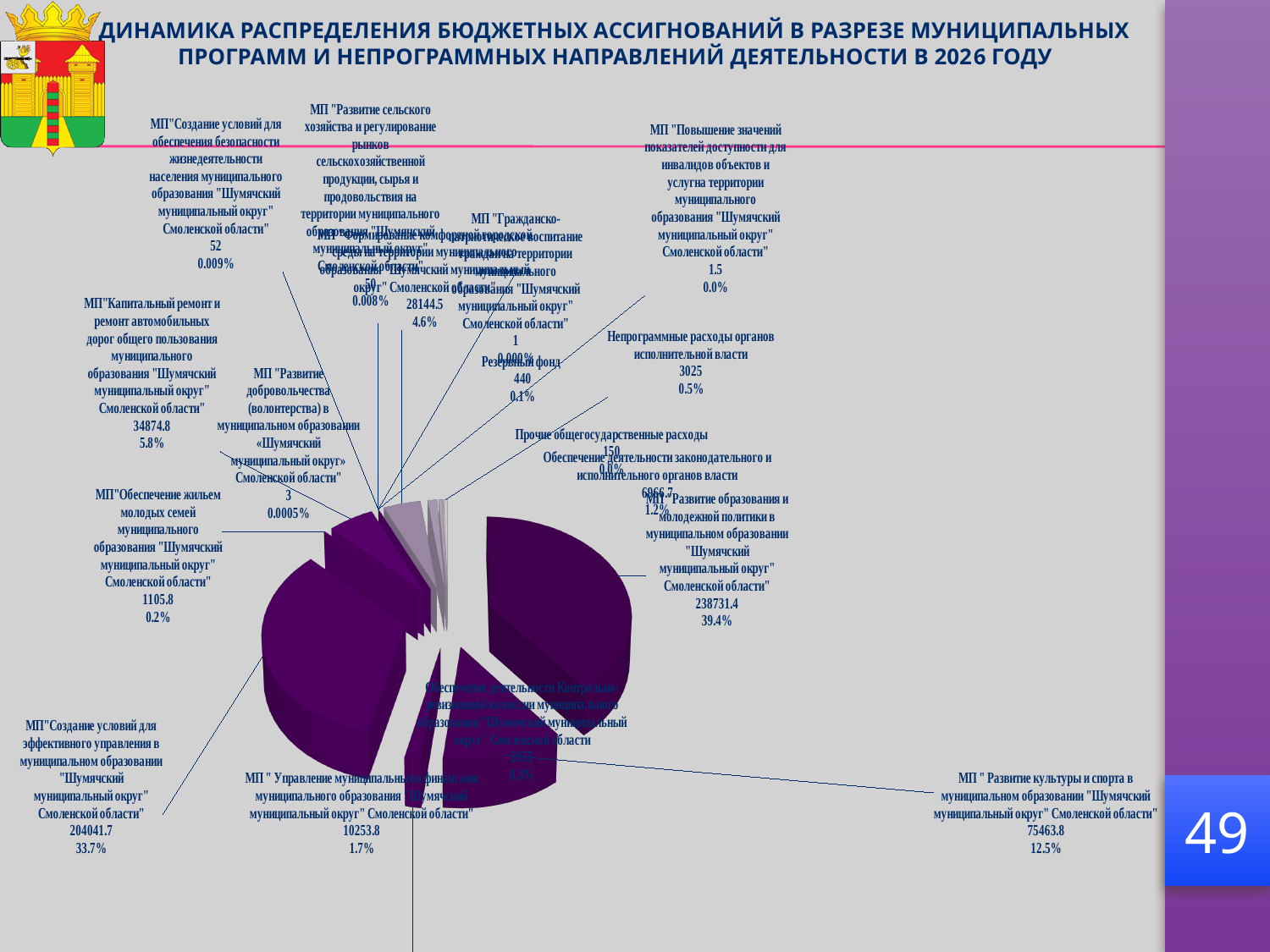
What value is shown for МП "Капитальный ремонт и ремонт автомобильных дорог общего пользования"? 34874.8 What kind of chart is shown on the slide? pie chart What share of the pie does МП "Управление муниципальными финансами" account for? 1.7% What value is shown for Резервный фонд? 440 What is the difference between the value for МП "Развитие образования и молодежной политики" and the value for МП "Создание условий для эффективного управления"? 34689.7 What share of the pie does МП "Развитие образования и молодежной политики" account for? 39.4% What value is shown for МП "Развитие образования и молодежной политики в муниципальном образовании "Шумячский муниципальный округ" Смоленской области"? 238731.4 Which is larger: the value for МП "Развитие культуры и спорта" or the value for МП "Капитальный ремонт и ремонт автомобильных дорог общего пользования"? МП "Развитие культуры и спорта" What value is shown for Непрограммные расходы органов исполнительной власти? 3025 What share of the pie does МП "Развитие культуры и спорта" account for? 12.5% What value is shown for МП "Создание условий для эффективного управления в муниципальном образовании "Шумячский муниципальный округ" Смоленской области"? 204041.7 Which category has the largest share of the pie? МП "Развитие образования и молодежной политики в муниципальном образовании "Шумячский муниципальный округ" Смоленской области"